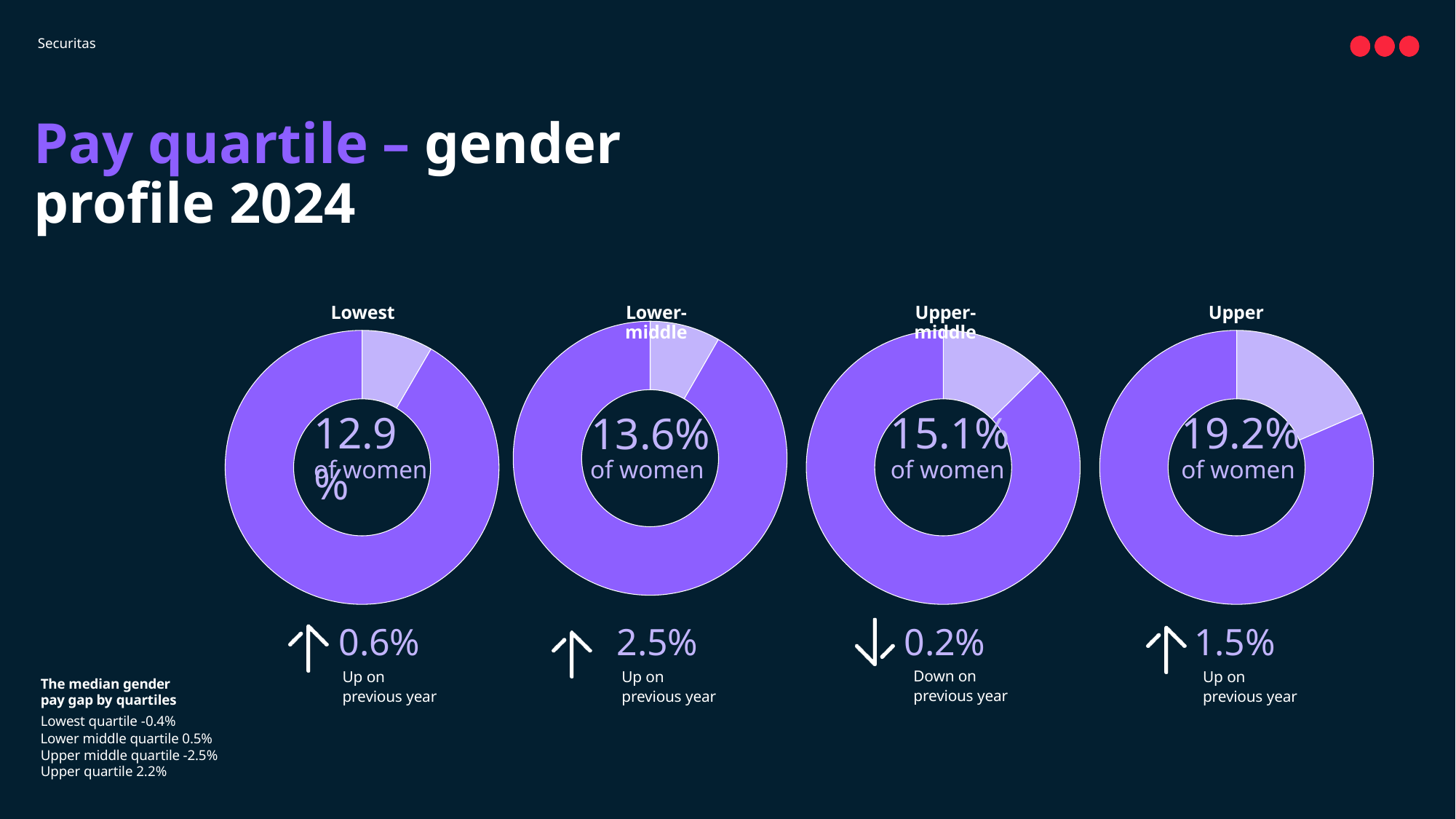
Which quartile's donut chart shows the lowest percentage of women? Lowest In the Lowest quartile donut chart, what percentage of women is shown? 12.9% In the Upper quartile donut chart, what percentage of women is shown? 19.2% Which quartile's donut chart shows the highest percentage of women? Upper Below the Upper-middle quartile donut chart, by how much did the percentage of women change on the previous year? 0.2% down In the Upper-middle quartile donut chart, what percentage of women is shown? 15.1% In the Lower-middle quartile donut chart, what percentage of women is shown? 13.6% Which shows a larger percentage of women: the Lower-middle quartile chart or the Upper-middle quartile chart? Upper-middle What kind of chart is used to show the percentage of women in each pay quartile? Donut (pie) chart What is the difference between the percentage of women in the Upper quartile chart and the Lowest quartile chart? 6.3% Reading the donut charts from left to right (Lowest to Upper), does the percentage of women rise or fall? Rise How many donut charts are shown on the slide? 4